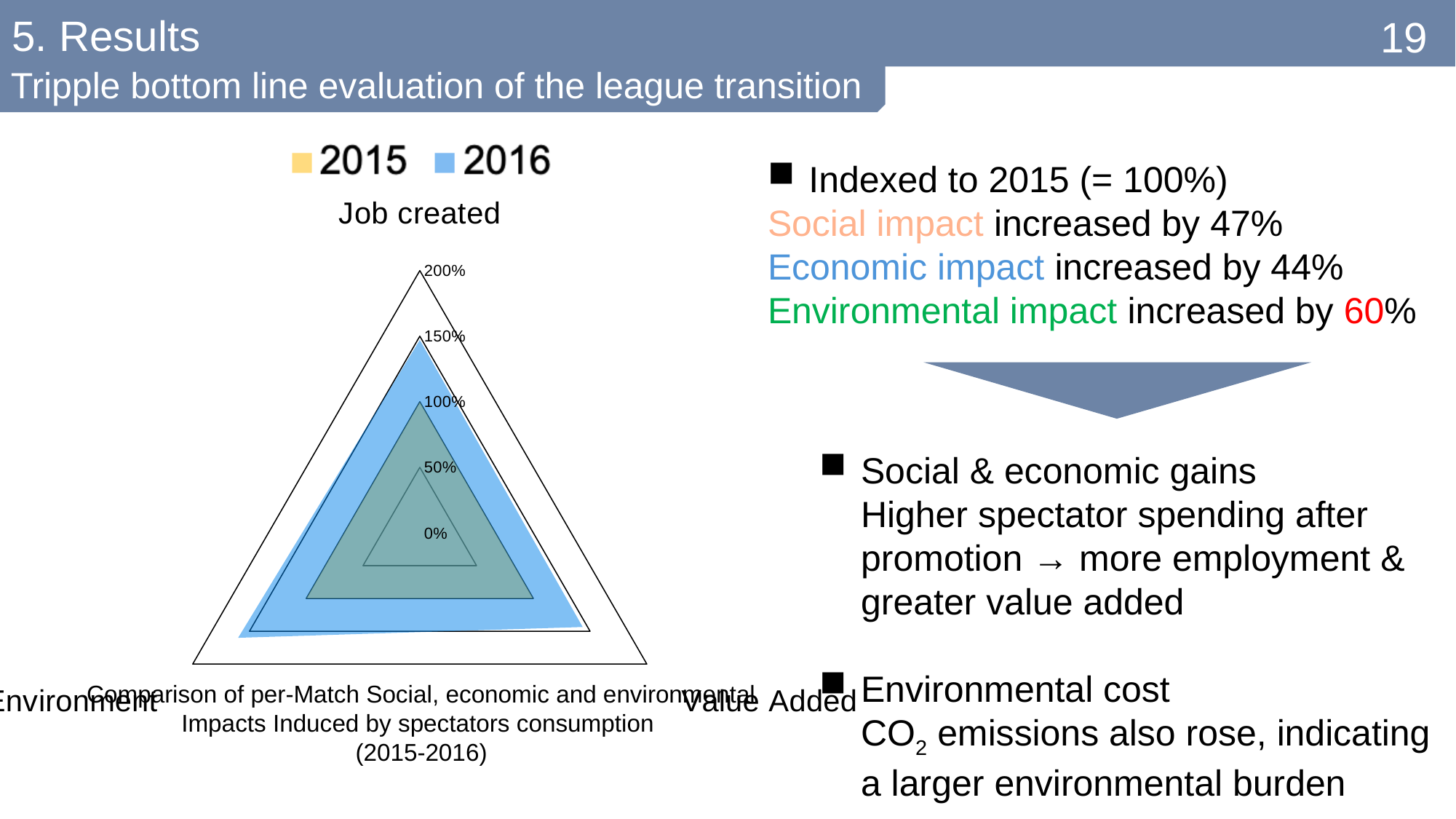
On which axis does the 2016 series reach its highest value? Environment Is the 2016 value for Environment greater or less than 100%? greater Is the 2016 value for Job created greater or less than 100%? greater What is the value for 2015 on the Environment axis? 100% How many series does the chart legend list? 2 Which is larger on the Value Added axis, the 2015 value or the 2016 value? 2016 What is the highest tick value shown on the radar chart's scale? 200% What kind of chart is shown on the slide? Radar chart Is the 2016 value for Value Added greater or less than 200%? less How many categories (axes) does the radar chart have? 3 Which series is shown in blue in the chart legend? 2016 What is the value for 2015 on the Job created axis? 100%